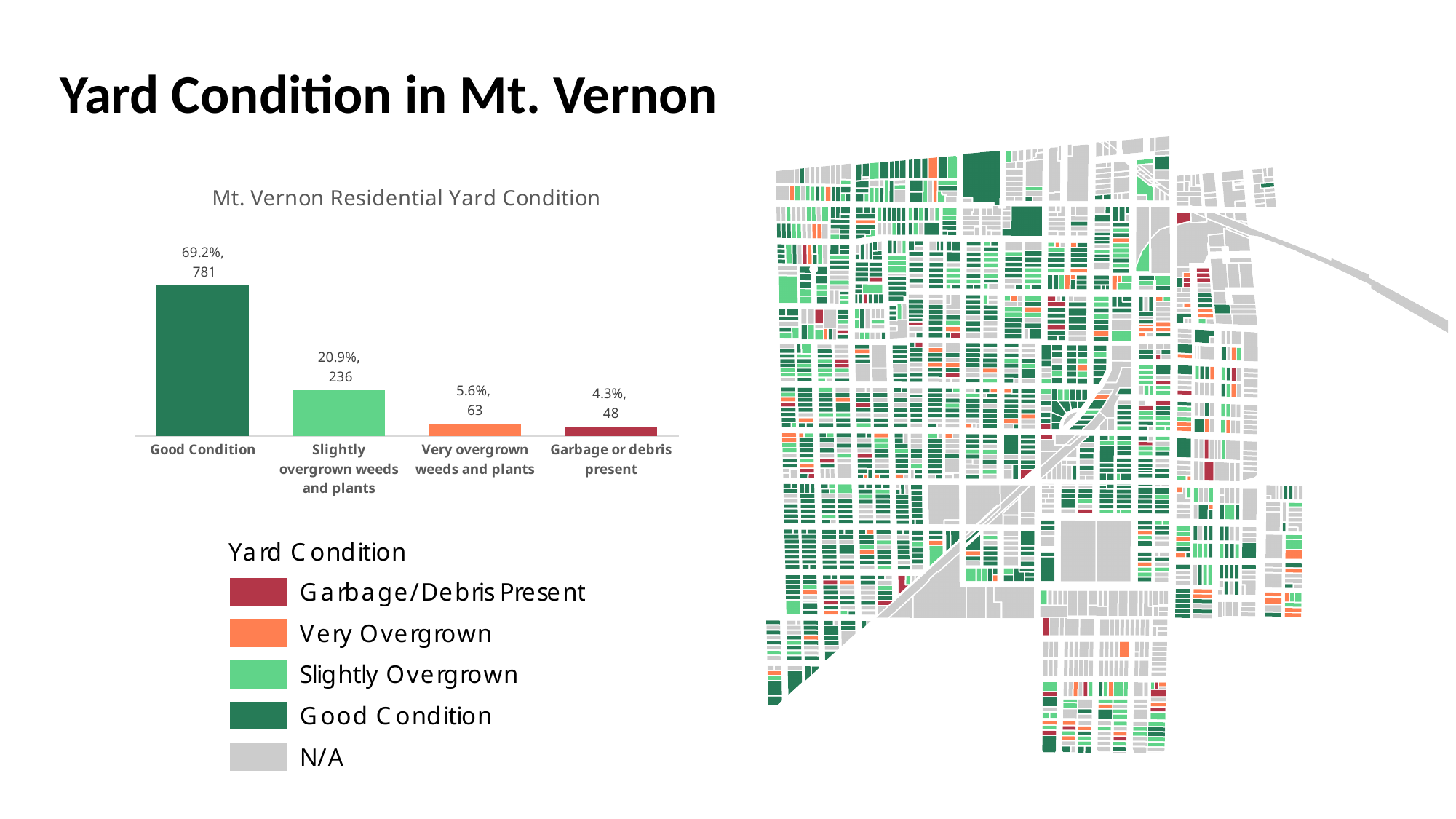
How many categories are shown in the Mt. Vernon Residential Yard Condition bar chart? 4 What type of chart is the Mt. Vernon Residential Yard Condition chart? bar chart Do the values in the bar chart rise or fall from left to right across the categories? fall In the bar chart, which is larger: the count for Very overgrown weeds and plants or for Garbage or debris present? Very overgrown weeds and plants Which category has the highest value in the Mt. Vernon Residential Yard Condition bar chart? Good Condition Which category has the lowest value in the Mt. Vernon Residential Yard Condition bar chart? Garbage or debris present In the bar chart, what count is shown for Good Condition? 781 In the bar chart, what count is shown for Very overgrown weeds and plants? 63 In the bar chart, what is the difference in count between Good Condition and Slightly overgrown weeds and plants? 545 In the bar chart, what percentage is shown for Slightly overgrown weeds and plants? 20.9% What is the title of the bar chart on the slide? Mt. Vernon Residential Yard Condition In the bar chart, what percentage is shown for Garbage or debris present? 4.3%